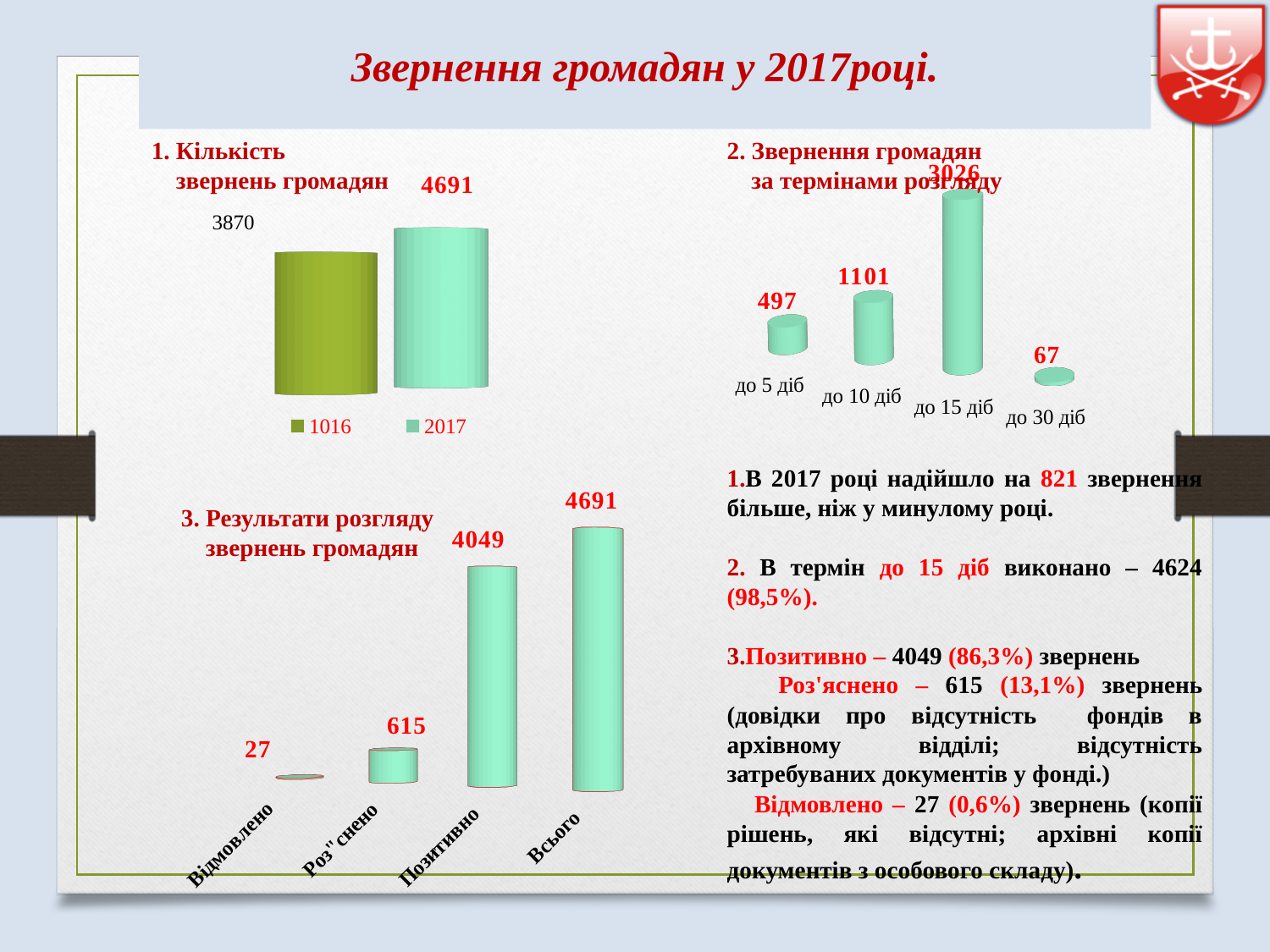
In the chart "Звернення громадян за термінами розгляду", how many categories are shown? 4 In the chart "Результати розгляду звернень громадян", what is the value for "Всього"? 4691 In the chart "Кількість звернень громадян", how many series does the legend list? 2 In the chart "Звернення громадян за термінами розгляду", what is the value for "до 10 діб"? 1101 What kind of chart is "Результати розгляду звернень громадян"? bar chart In the chart "Звернення громадян за термінами розгляду", which category has the lowest value? до 30 діб In the chart "Кількість звернень громадян", what is the difference between the two bars (4691 and 3870)? 821 In the chart "Звернення громадян за термінами розгляду", what is the difference between "до 10 діб" and "до 5 діб"? 604 In the chart "Результати розгляду звернень громадян", which is larger: "Роз''снено" or "Відмовлено"? Роз''снено In the chart "Кількість звернень громадян", what is the value for the series 2017? 4691 In the chart "Звернення громадян за термінами розгляду", which category has the highest value? до 15 діб In the chart "Результати розгляду звернень громадян", what is the value for "Позитивно"? 4049